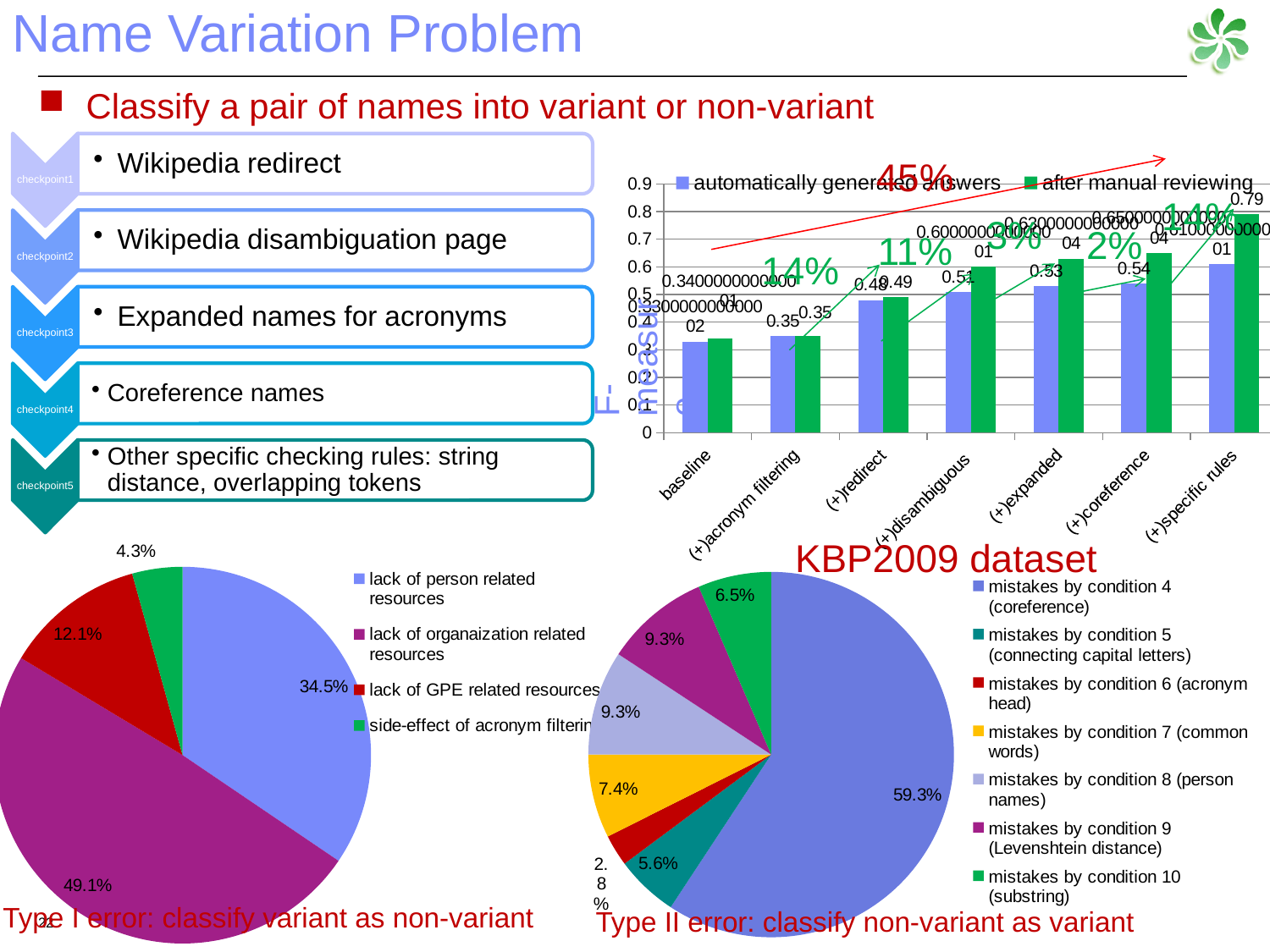
In the bar chart at the top right, how many series does the legend list? 2 In the pie chart at the bottom left (Type I error), what share is 'lack of organaization related resources'? 49.1% In the pie chart at the bottom right (Type II error), what share is 'mistakes by condition 4 (coreference)'? 59.3% In the pie chart at the bottom right (Type II error), what is the difference between the shares for condition 7 (common words) and condition 5 (connecting capital letters)? 1.8% In the bar chart at the top right, which category has the highest 'after manual reviewing' value? (+)specific rules In the bar chart at the top right, what is the value for (+)specific rules in the 'after manual reviewing' series? 0.79 In the bar chart at the top right, how many categories are shown on the x axis? 7 In the bar chart at the top right, do the 'after manual reviewing' values rise or fall from baseline to (+)specific rules? rise In the bar chart at the top right, what is the value for (+)coreference in the 'automatically generated answers' series? 0.54 In the bar chart at the top right, is the 'after manual reviewing' value for (+)disambiguous greater or less than 0.5? greater In the pie chart at the bottom right (Type II error), how many entries does the legend list? 7 In the pie chart at the bottom left (Type I error), which category has the smallest slice? side-effect of acronym filtering